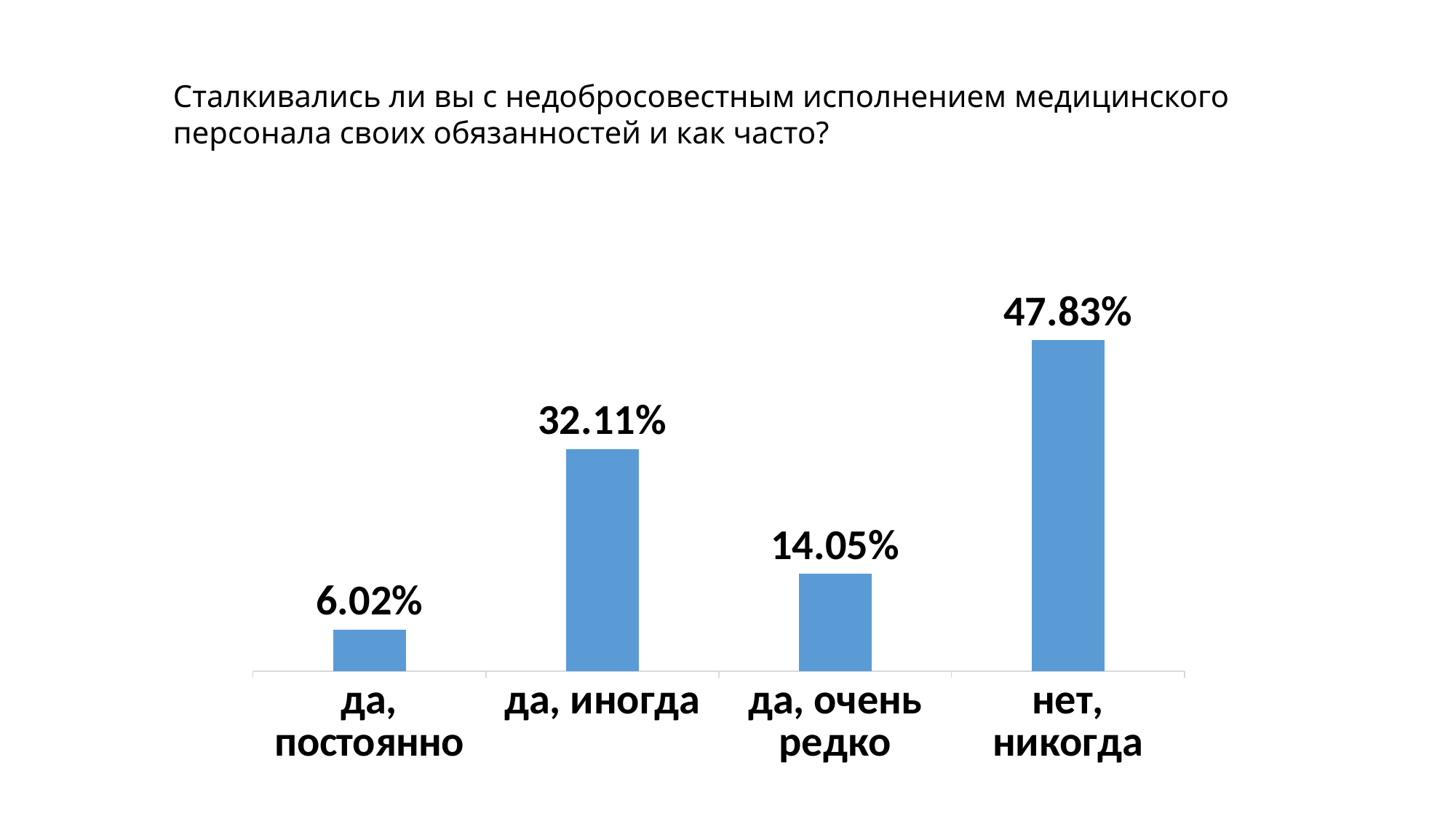
What colour are the bars in the chart? blue Which is larger, the value for "да, иногда" or the value for "да, очень редко"? да, иногда Which category has the lowest value? да, постоянно Which category has the highest value? нет, никогда What kind of chart is shown on the slide? bar chart What is the value for "да, иногда"? 32.11% What is the difference between the values for "да, очень редко" and "да, постоянно"? 8.03% What is the value for "да, очень редко"? 14.05% What is the value for "да, постоянно"? 6.02% What is the value for "нет, никогда"? 47.83% What is the difference between the values for "нет, никогда" and "да, иногда"? 15.72% How many categories are shown in the chart? 4